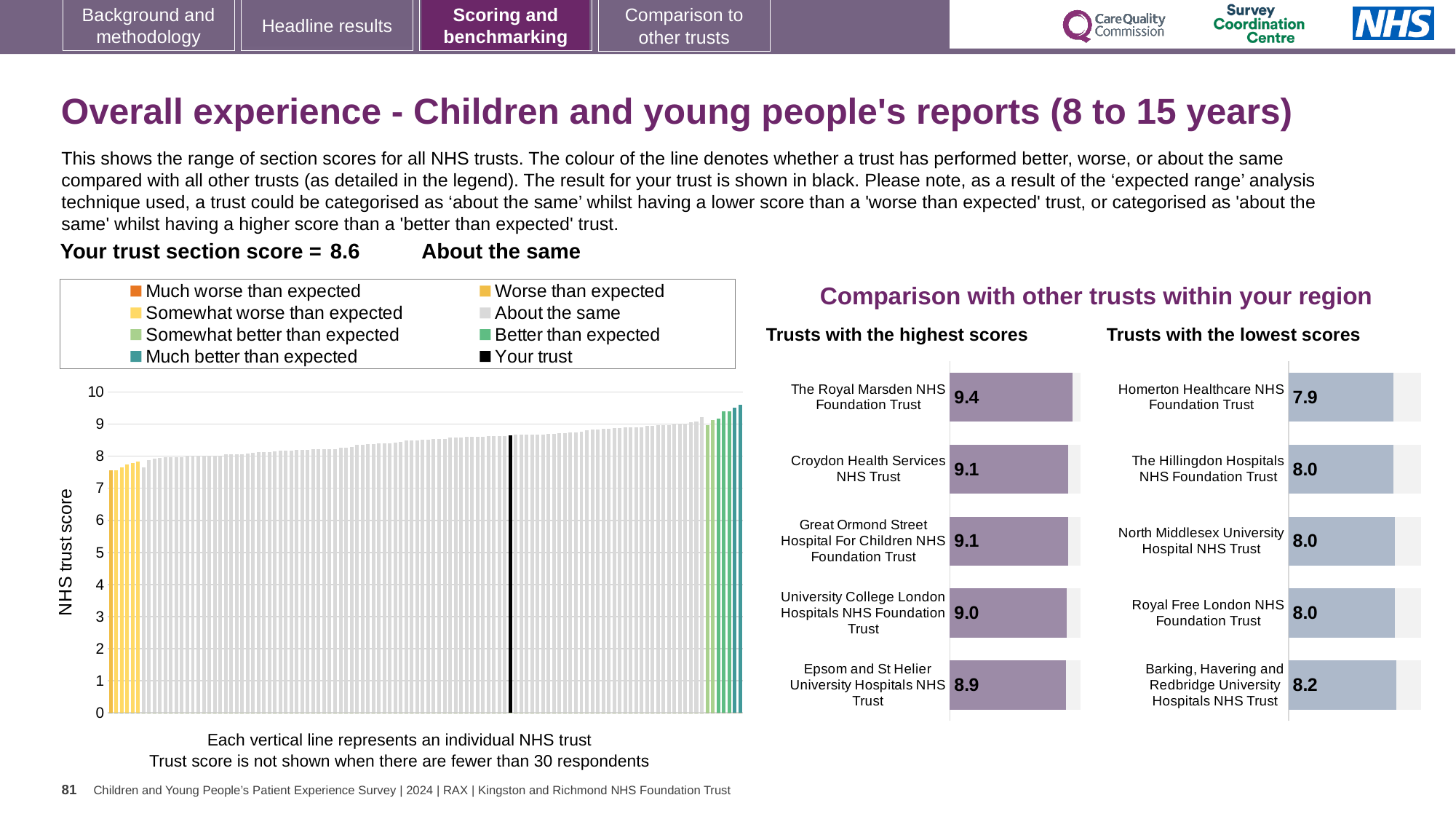
In the main chart on the left, is the value for the black 'Your trust' bar greater or less than 8? greater What kind of chart is the main chart on the left of the slide? Bar chart In the 'Trusts with the highest scores' chart, what is the score for Epsom and St Helier University Hospitals NHS Trust? 8.9 How many trusts are shown in the 'Trusts with the highest scores' chart? 5 How many entries does the legend of the main chart on the left list? 8 In the 'Trusts with the lowest scores' chart, what is the score for Homerton Healthcare NHS Foundation Trust? 7.9 In the 'Trusts with the lowest scores' chart, which trust has the lowest score? Homerton Healthcare NHS Foundation Trust In the 'Trusts with the lowest scores' chart, what is the score for Barking, Havering and Redbridge University Hospitals NHS Trust? 8.2 In the 'Trusts with the highest scores' chart, what is the difference between the scores of The Royal Marsden NHS Foundation Trust and Epsom and St Helier University Hospitals NHS Trust? 0.5 In the 'Trusts with the highest scores' chart, which trust has the highest score? The Royal Marsden NHS Foundation Trust In the 'Trusts with the lowest scores' chart, which has the larger score: Homerton Healthcare NHS Foundation Trust or Barking, Havering and Redbridge University Hospitals NHS Trust? Barking, Havering and Redbridge University Hospitals NHS Trust In the 'Trusts with the highest scores' chart, what is the score for The Royal Marsden NHS Foundation Trust? 9.4